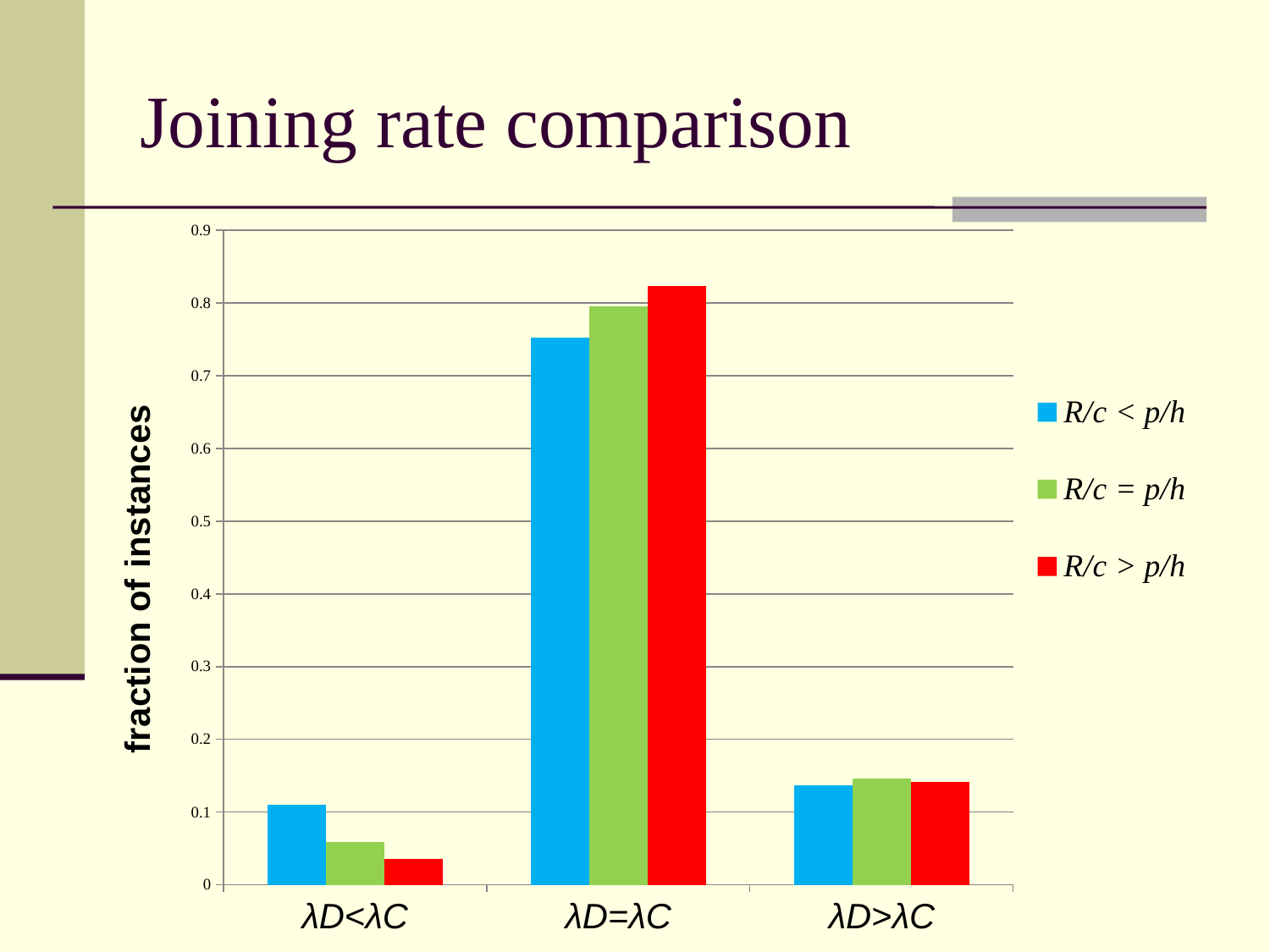
What kind of chart is shown on the slide? bar chart In the λD<λC category, which is larger: R/c < p/h or R/c > p/h? R/c < p/h Which colour represents the R/c = p/h series? green In the λD<λC category, which series has the lowest value? R/c > p/h Is the value for R/c < p/h at λD=λC greater or less than 0.7? greater How many series does the legend list? 3 How many categories are shown on the x axis? 3 Is the value for R/c > p/h at λD<λC greater or less than 0.1? less Is the value for R/c < p/h at λD>λC greater or less than 0.1? greater For the R/c > p/h series, which category has the highest value? λD=λC What is the label of the y axis? fraction of instances